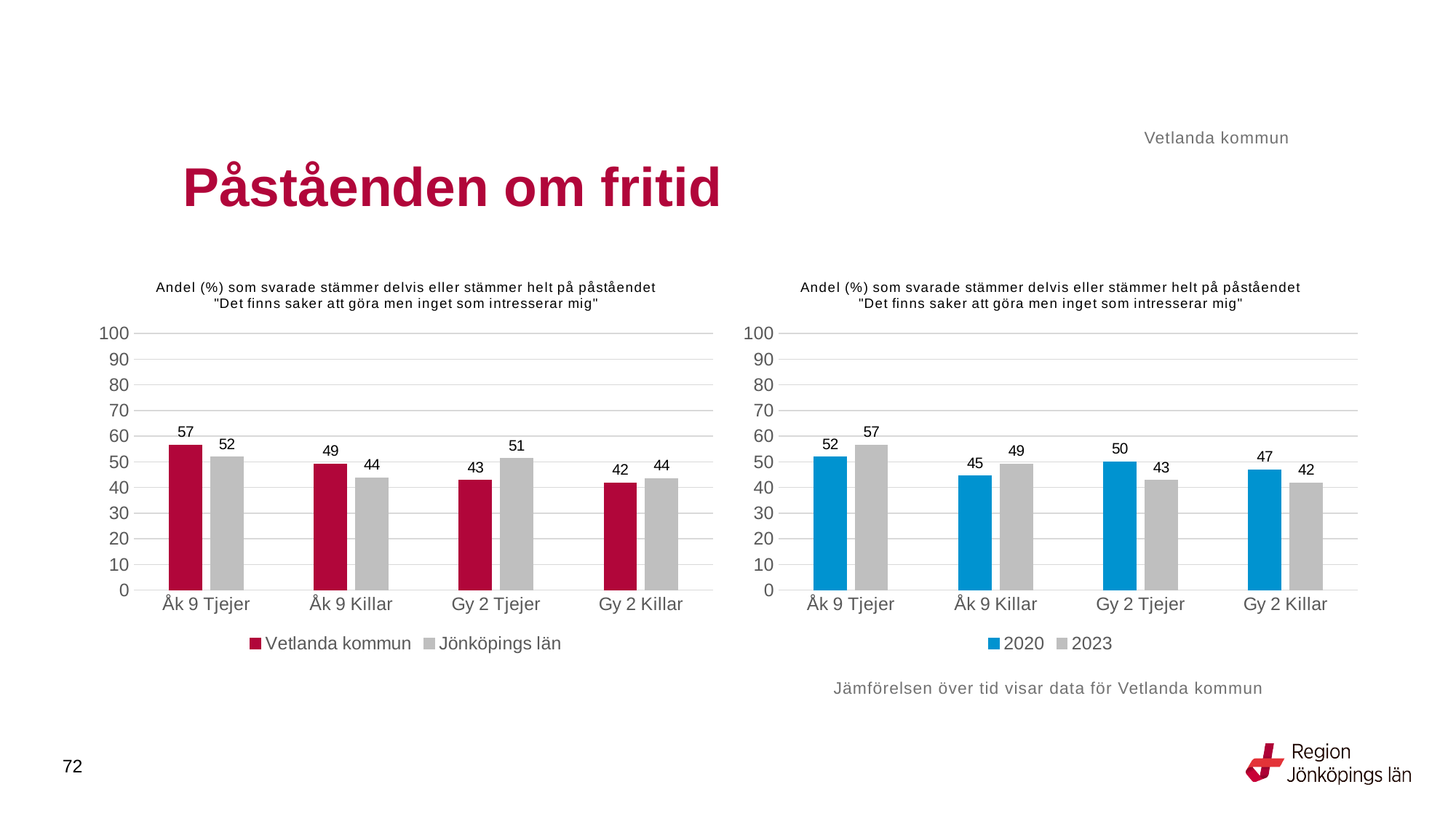
How many categories are shown on the x axis of the left chart? 4 In the left chart, which is larger for Gy 2 Tjejer: Vetlanda kommun or Jönköpings län? Jönköpings län In the left chart, what is the value for Vetlanda kommun for Åk 9 Tjejer? 57 In the left chart, which category has the lowest value for Vetlanda kommun? Gy 2 Killar What kind of chart is the left chart? Bar chart How many series does the legend of the right chart list? 2 In the left chart, what is the value for Jönköpings län for Gy 2 Tjejer? 51 In the right chart, which category has the highest value for 2020? Åk 9 Tjejer In the right chart, what is the value for 2020 for Gy 2 Killar? 47 In the right chart, what is the value for 2023 for Åk 9 Tjejer? 57 In the right chart, what is the difference between 2020 and 2023 for Gy 2 Tjejer? 7 In the left chart, what is the difference between Vetlanda kommun and Jönköpings län for Åk 9 Killar? 5